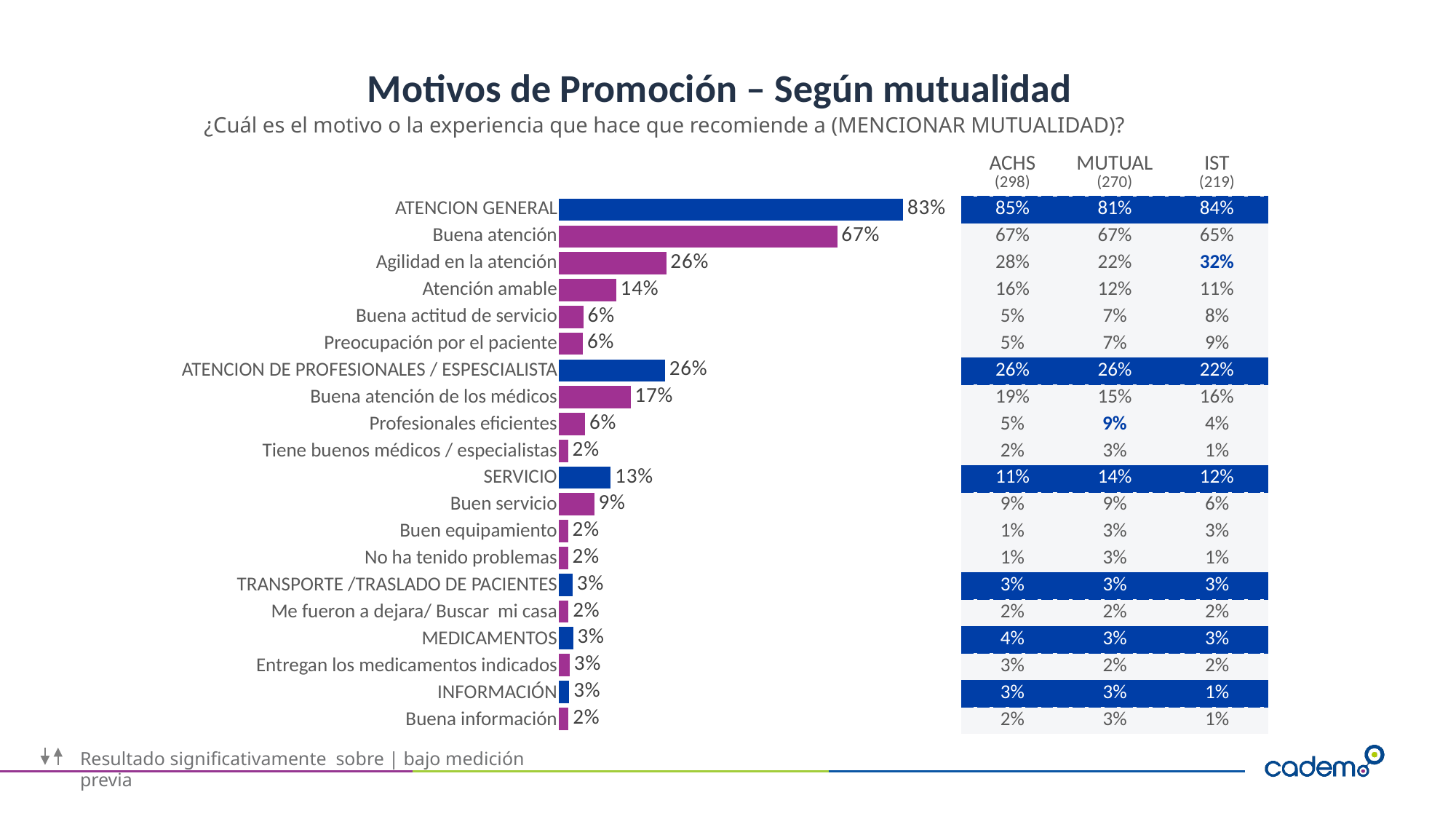
What is the difference between the values for ATENCION GENERAL and Buena atención in the bar chart? 16 percentage points What is the value shown for Atención amable in the bar chart? 14% What type of chart is shown on the slide? Bar chart What is the value shown for ATENCION GENERAL in the bar chart? 83% Which has a larger value in the bar chart, Buena atención or Agilidad en la atención? Buena atención What is the difference between the values for Agilidad en la atención and Atención amable in the bar chart? 12 percentage points What is the value shown for SERVICIO in the bar chart? 13% Which category has the highest value in the bar chart? ATENCION GENERAL What is the value shown for Buena atención in the bar chart? 67% How many bars are plotted in the bar chart? 20 What is the title of the slide containing the bar chart? Motivos de Promoción – Según mutualidad What is the value shown for Buena atención de los médicos in the bar chart? 17%